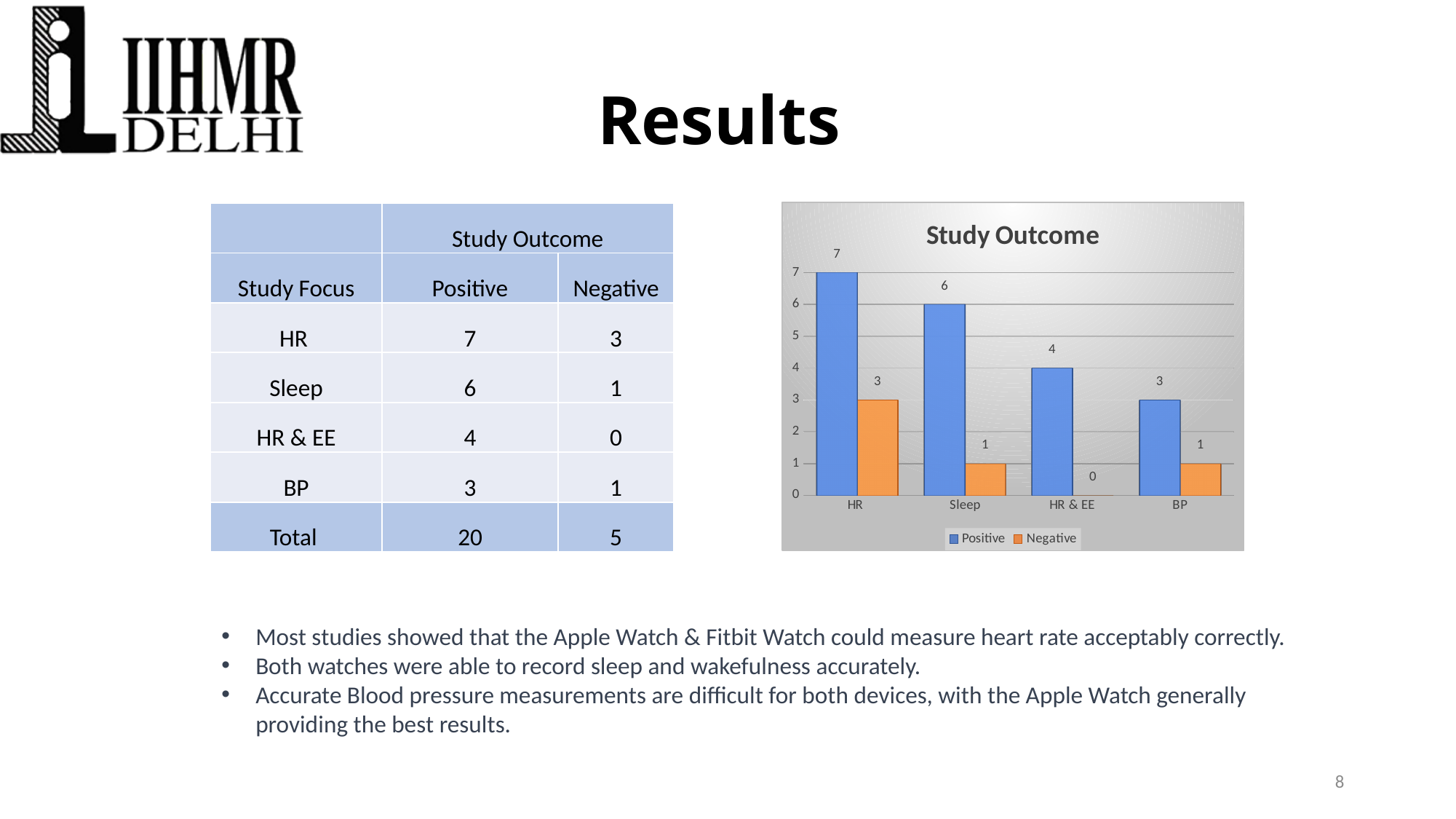
What kind of chart is the Study Outcome chart? Bar chart How many categories are shown on the x axis of the Study Outcome chart? 4 What is the Negative value for HR & EE in the Study Outcome chart? 0 Is the Positive value for HR & EE greater or less than 3 in the Study Outcome chart? greater Which is larger in the Study Outcome chart: the Positive value for Sleep or the Positive value for HR & EE? Positive value for Sleep Do the Positive values rise or fall from HR to BP in the Study Outcome chart? Fall Which category has the highest Positive value in the Study Outcome chart? HR Which category has the lowest Positive value in the Study Outcome chart? BP What is the Negative value for Sleep in the Study Outcome chart? 1 How many series does the legend of the Study Outcome chart list? 2 What is the difference between the Positive and Negative values for HR in the Study Outcome chart? 4 What is the Positive value for HR in the Study Outcome chart? 7